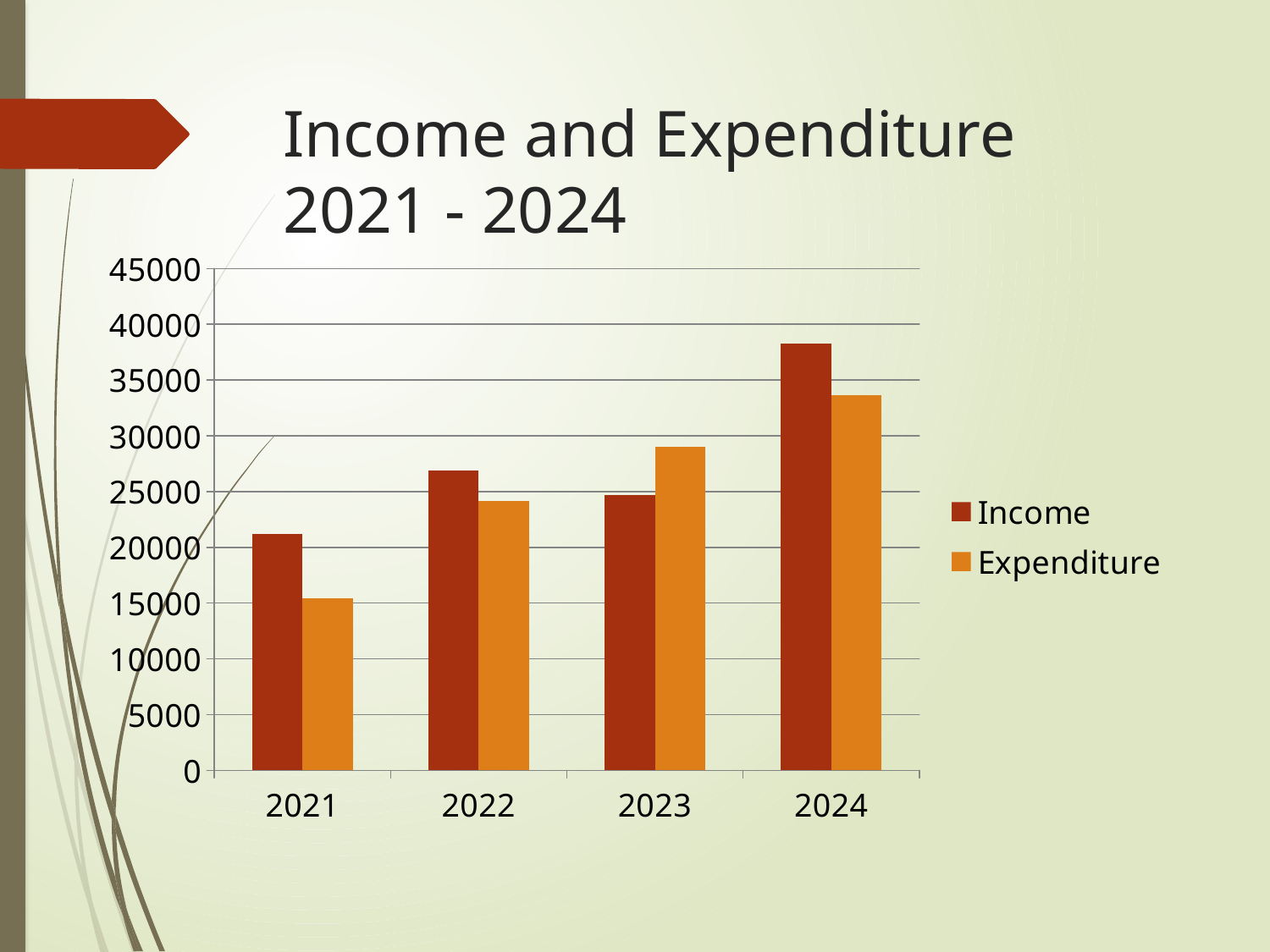
In 2023, which is larger, Income or Expenditure? Expenditure In 2022, which is larger, Income or Expenditure? Income What is the title of the chart? Income and Expenditure 2021 - 2024 How many series does the legend list? 2 Is the Income value for 2024 greater or less than 35000? greater What type of chart is shown on the slide? Bar chart Which year has the highest Income? 2024 Is the Expenditure value for 2021 greater or less than 20000? less Is the Expenditure value for 2024 greater or less than 35000? less How many years are shown on the x axis? 4 Does Expenditure rise or fall from 2021 to 2024? Rises Which year has the lowest Expenditure? 2021